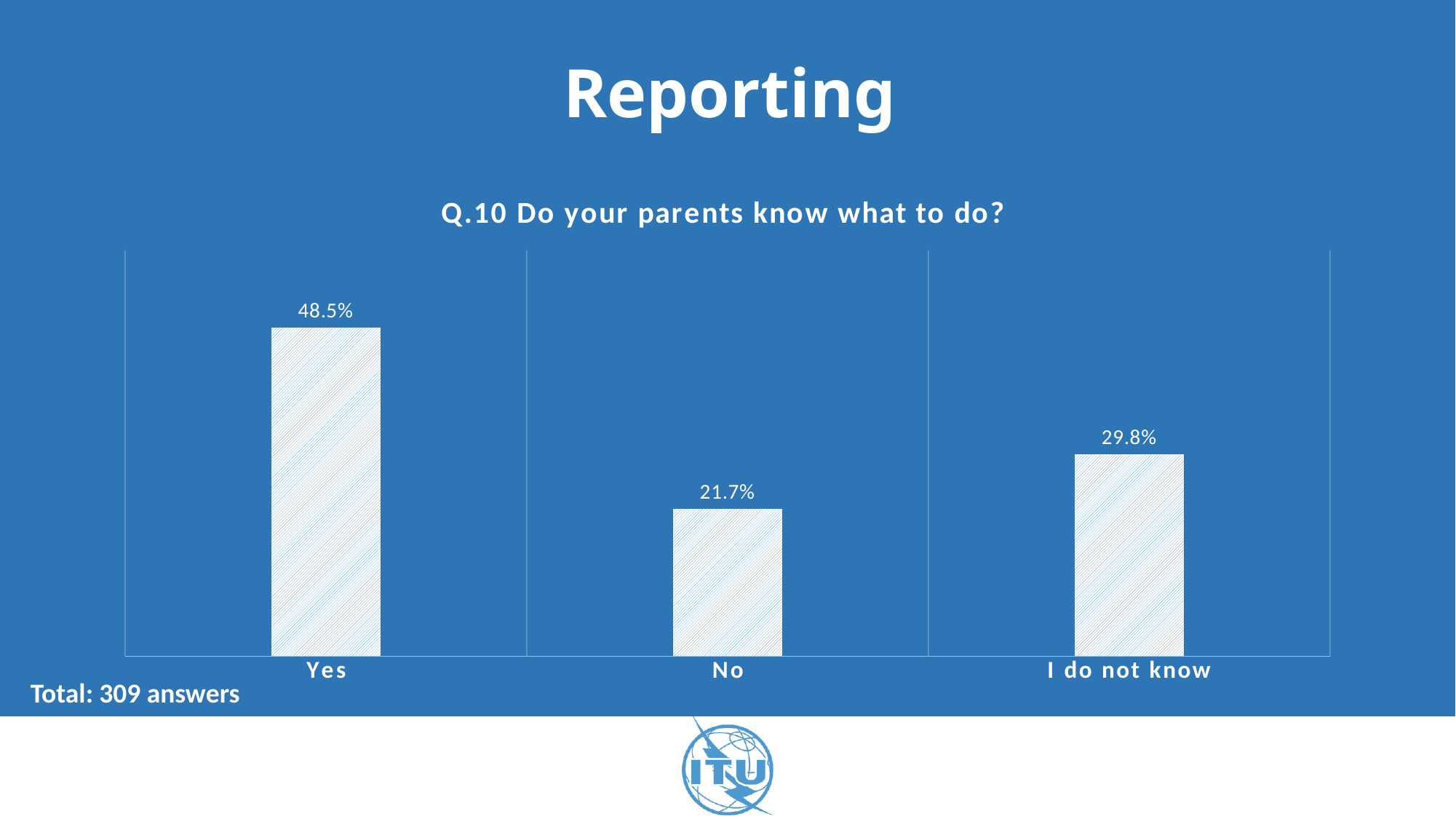
Which answer category has the lowest percentage? No How many answer categories are shown in the chart? 3 How many total answers does the slide say the chart is based on? 309 Which answer category has the highest percentage? Yes What is the title of the chart? Q.10 Do your parents know what to do? What kind of chart is shown on the slide? Bar chart What is the difference in percentage points between "I do not know" and "No"? 8.1 What percentage of respondents answered "No"? 21.7% What is the difference in percentage points between "Yes" and "No"? 26.8 What percentage of respondents answered "Yes" to Q.10 Do your parents know what to do? 48.5% What percentage of respondents answered "I do not know"? 29.8% Which is larger, the percentage for "No" or for "I do not know"? I do not know